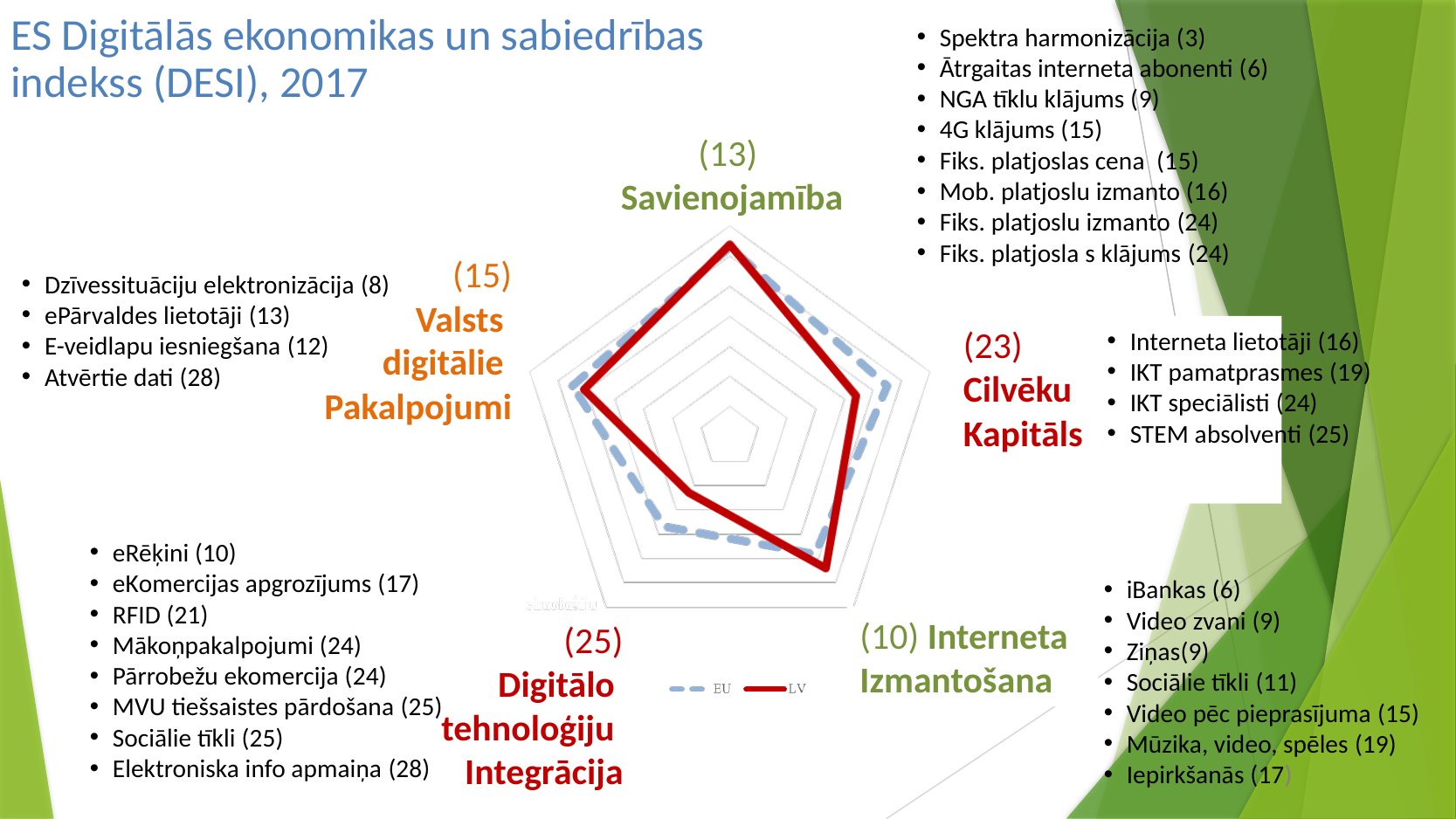
How many axes (dimensions) does the radar chart have? 5 On the Digitālo tehnoloģiju Integrācija axis, which series has the larger value, EU or LV? EU On the Interneta Izmantošana axis, which series has the larger value, EU or LV? LV On the Savienojamība axis, which series has the larger value, EU or LV? LV What kind of chart is shown on the slide? Radar chart On which axis does the LV series reach its highest value? Savienojamība On which axis does the LV series have its lowest value? Digitālo tehnoloģiju Integrācija Which series is drawn with a dashed line in the chart? EU Which two series are listed in the chart's legend? EU and LV How many series does the chart's legend list? 2